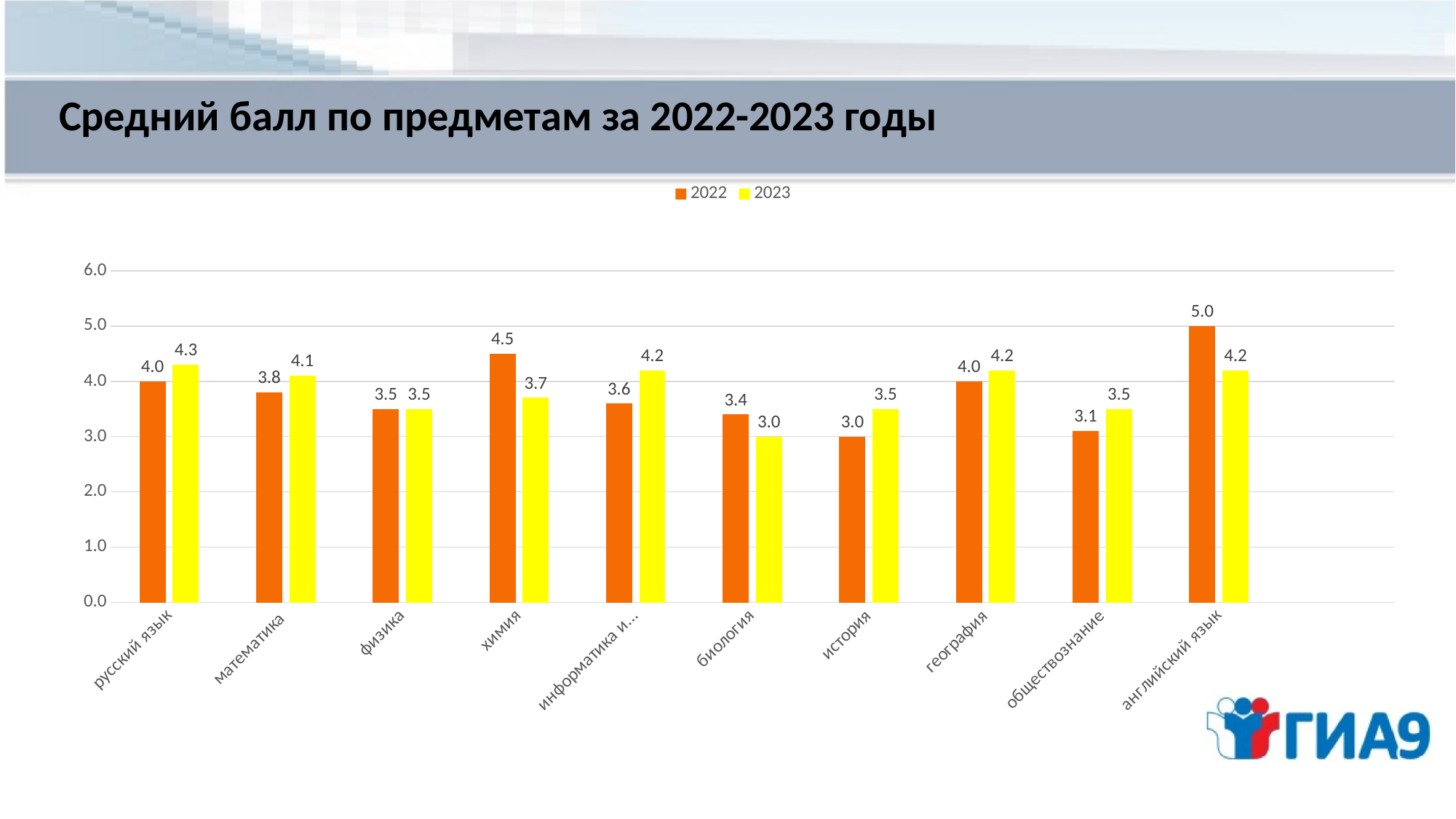
Which subject has the highest 2022 value? английский язык How many series does the legend list? 2 What is the 2023 value for математика? 4.1 How many subjects are shown on the x axis? 10 What kind of chart is shown on the slide? bar chart What is the title of the slide? Средний балл по предметам за 2022-2023 годы What is the 2022 value for химия? 4.5 What is the difference between the 2022 and 2023 values for английский язык? 0.8 Which subject has the lowest 2023 value? биология What is the 2022 value for обществознание? 3.1 Which subject has the highest 2023 value? русский язык Which is larger for биология: the 2022 value or the 2023 value? 2022